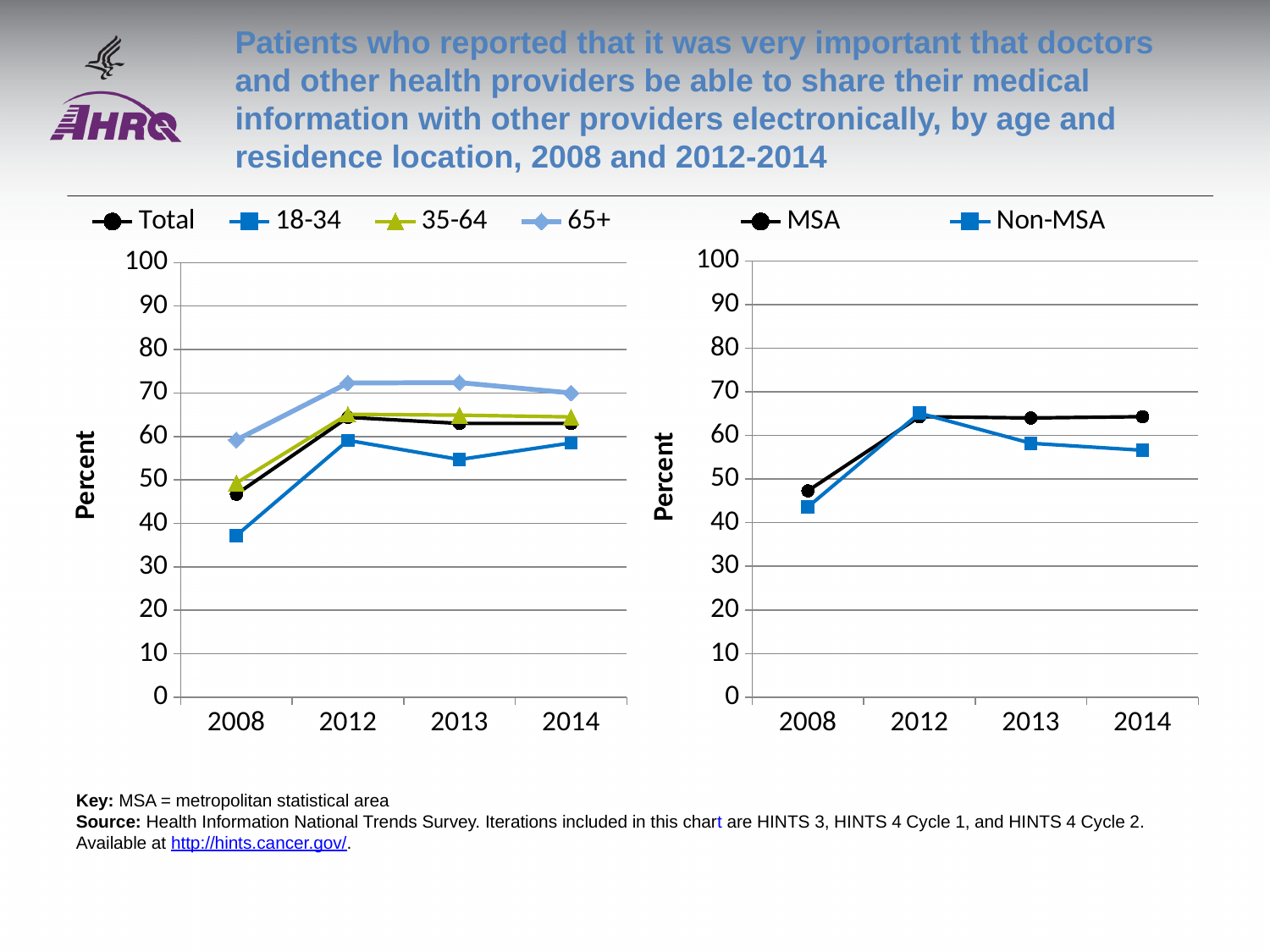
What kind of chart is the left chart (by age)? line chart How many series does the legend of the left chart (by age) list? 4 What is the y-axis label of the left chart (by age)? Percent In the left chart (by age), is the value for 65+ in 2012 greater or less than 70? greater In the left chart (by age), which age group has the highest value in 2008? 65+ In the left chart (by age), does the 18-34 line rise or fall from 2008 to 2012? rise In the left chart (by age), which age group has the lowest value in 2008? 18-34 How many series does the legend of the right chart (MSA / Non-MSA) list? 2 In the right chart (MSA / Non-MSA), is the value for Non-MSA in 2014 greater or less than 60? less In the left chart (by age), is the value for 18-34 in 2008 greater or less than 40? less How many years are shown on the x axis of the right chart (MSA / Non-MSA)? 4 In the right chart (MSA / Non-MSA), which is higher in 2014, MSA or Non-MSA? MSA